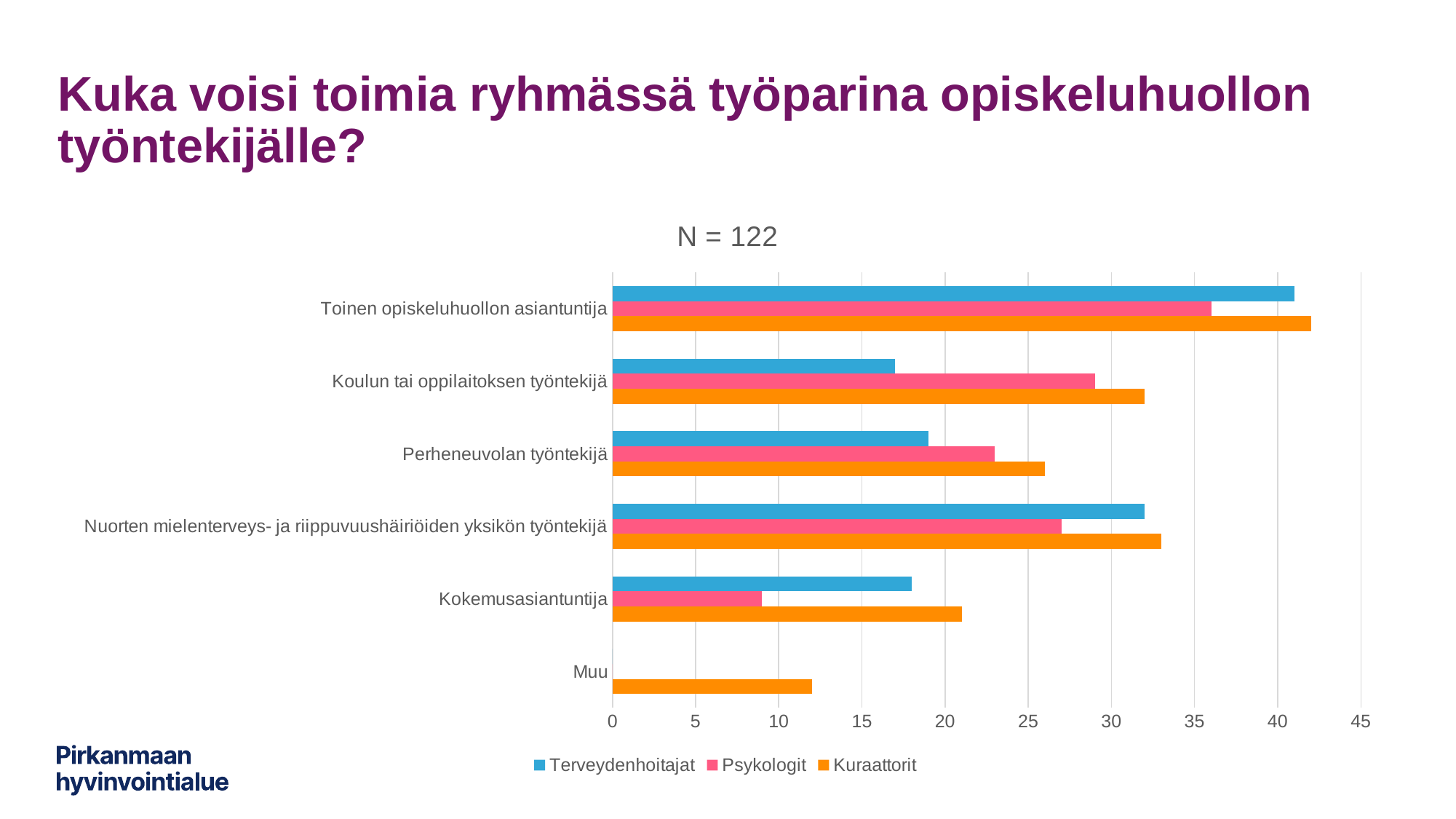
What is the title shown above the chart? N = 122 For which category is the Kuraattorit value highest? Toinen opiskeluhuollon asiantuntija For Koulun tai oppilaitoksen työntekijä, which is larger: the Terveydenhoitajat value or the Psykologit value? Psykologit Is the Terveydenhoitajat value for Koulun tai oppilaitoksen työntekijä greater or less than 20? less Is the Psykologit value for Perheneuvolan työntekijä greater or less than 25? less How many categories are listed on the vertical axis of the chart? 6 How many series does the chart legend list? 3 Which series is shown in orange in the chart? Kuraattorit Is the Kuraattorit value for Toinen opiskeluhuollon asiantuntija greater or less than 40? greater For which category is the Kuraattorit value lowest? Muu What kind of chart is shown on the slide? bar chart